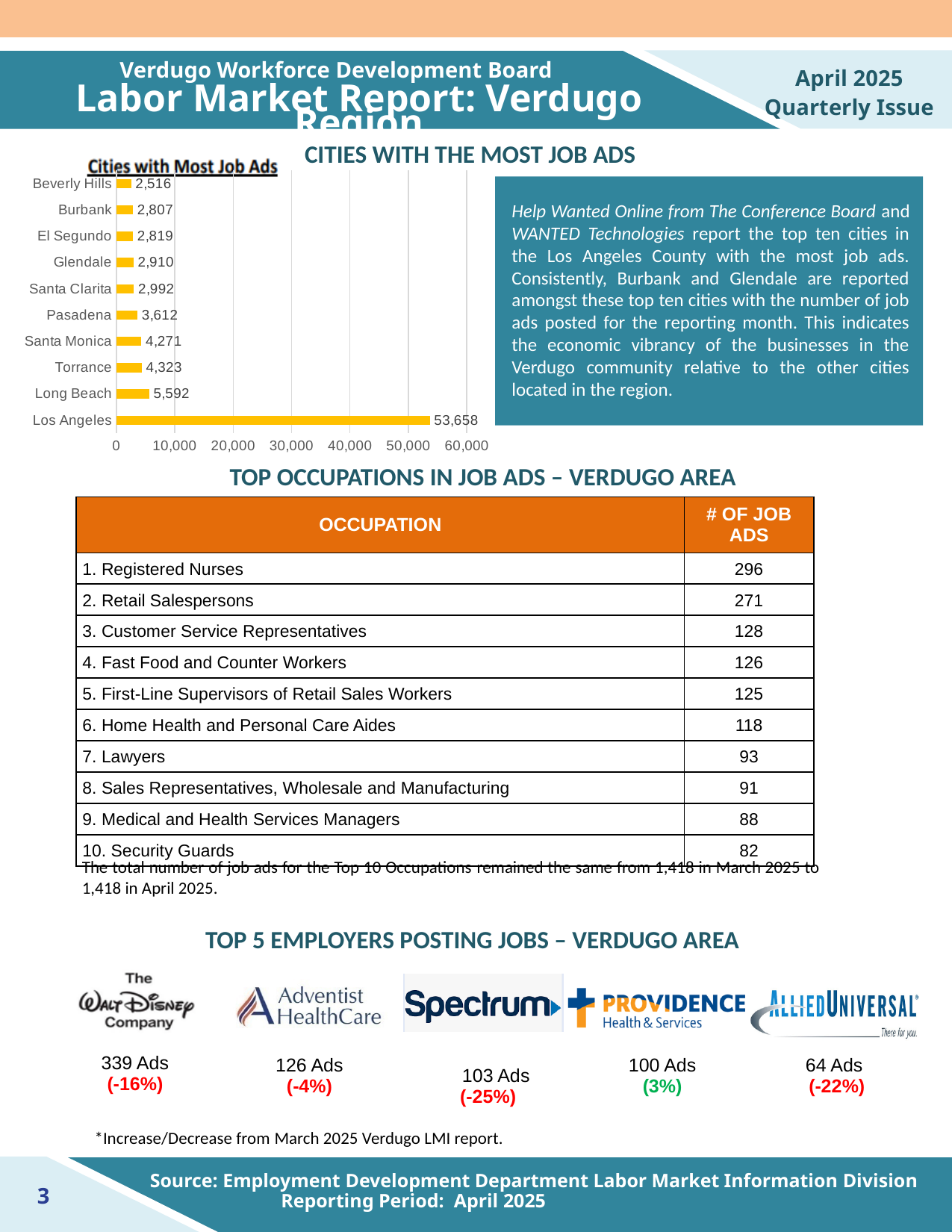
What is the maximum value shown on the horizontal axis of the Cities with Most Job Ads chart? 60,000 In the Cities with Most Job Ads chart, which has more job ads, Pasadena or Santa Monica? Santa Monica In the Cities with Most Job Ads chart, how many job ads does Burbank have? 2,807 In the Cities with Most Job Ads chart, which city has the fewest job ads? Beverly Hills In the Cities with Most Job Ads chart, what is the difference between the job ads for Los Angeles and Long Beach? 48,066 In the Cities with Most Job Ads chart, how many job ads does Glendale have? 2,910 How many cities are shown in the Cities with Most Job Ads chart? 10 What type of chart is the Cities with Most Job Ads chart? Bar chart In the Cities with Most Job Ads chart, which city has the most job ads? Los Angeles In the Cities with Most Job Ads chart, is the value for Los Angeles greater or less than 50,000? greater In the Cities with Most Job Ads chart, what is the difference between the job ads for Glendale and Burbank? 103 In the Cities with Most Job Ads chart, what is the value for Long Beach? 5,592